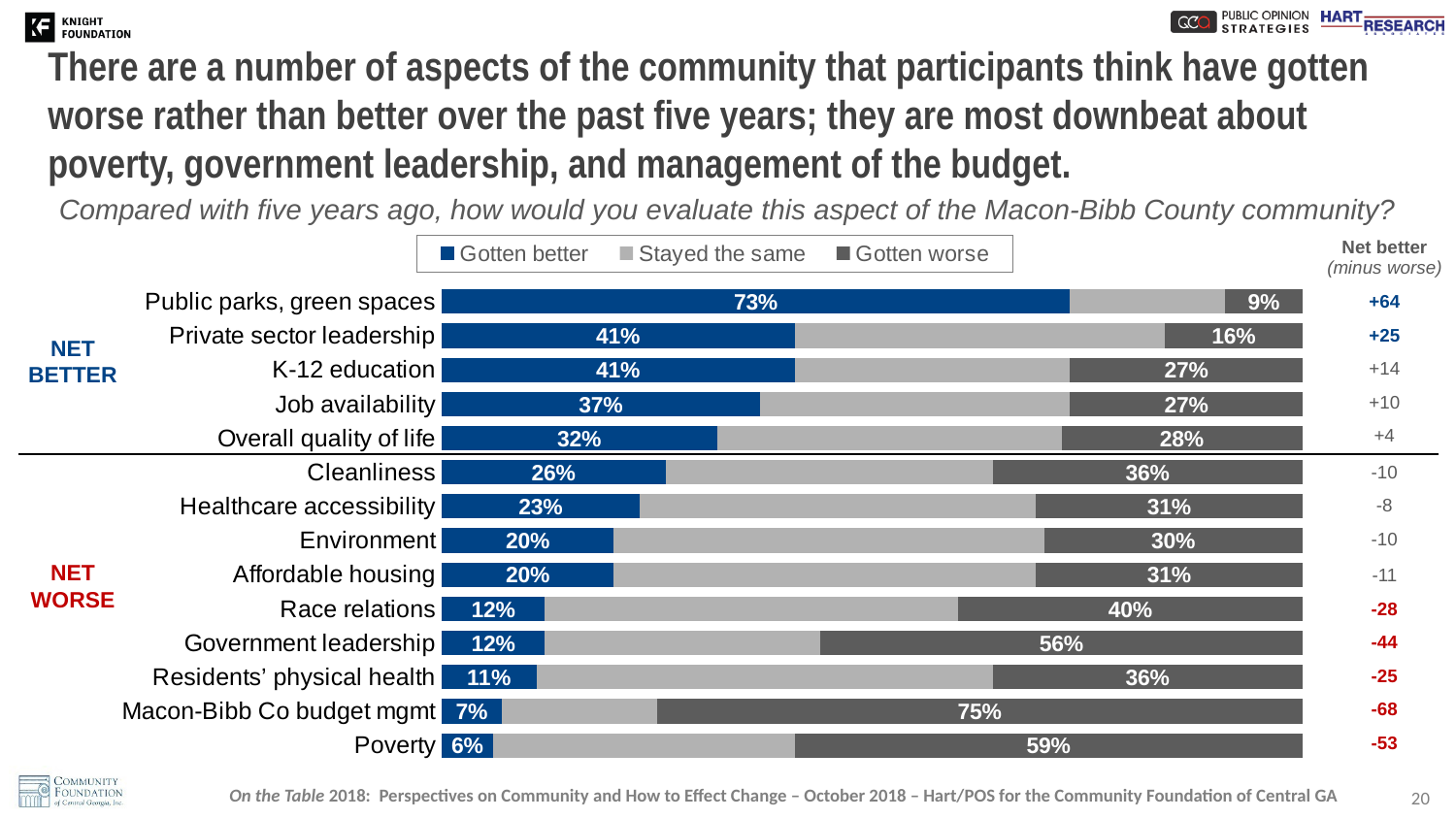
Which aspect has the highest 'Gotten better' percentage? Public parks, green spaces What kind of chart is shown on the slide? Stacked bar chart Which aspect has the highest 'Gotten worse' percentage? Macon-Bibb Co budget mgmt What percentage said government leadership has gotten worse? 56% What percentage of participants said public parks, green spaces have gotten better? 73% What percentage said Macon-Bibb Co budget mgmt has gotten worse? 75% Which aspect has the lowest 'Gotten better' percentage? Poverty How many series does the legend list? 3 Which has a larger 'Gotten worse' percentage: K-12 education or Cleanliness? Cleanliness For public parks, green spaces, what is the difference between the 'Gotten better' and 'Gotten worse' percentages? 64 percentage points What percentage said poverty has gotten better? 6% How many aspects of the community are listed in the chart? 14